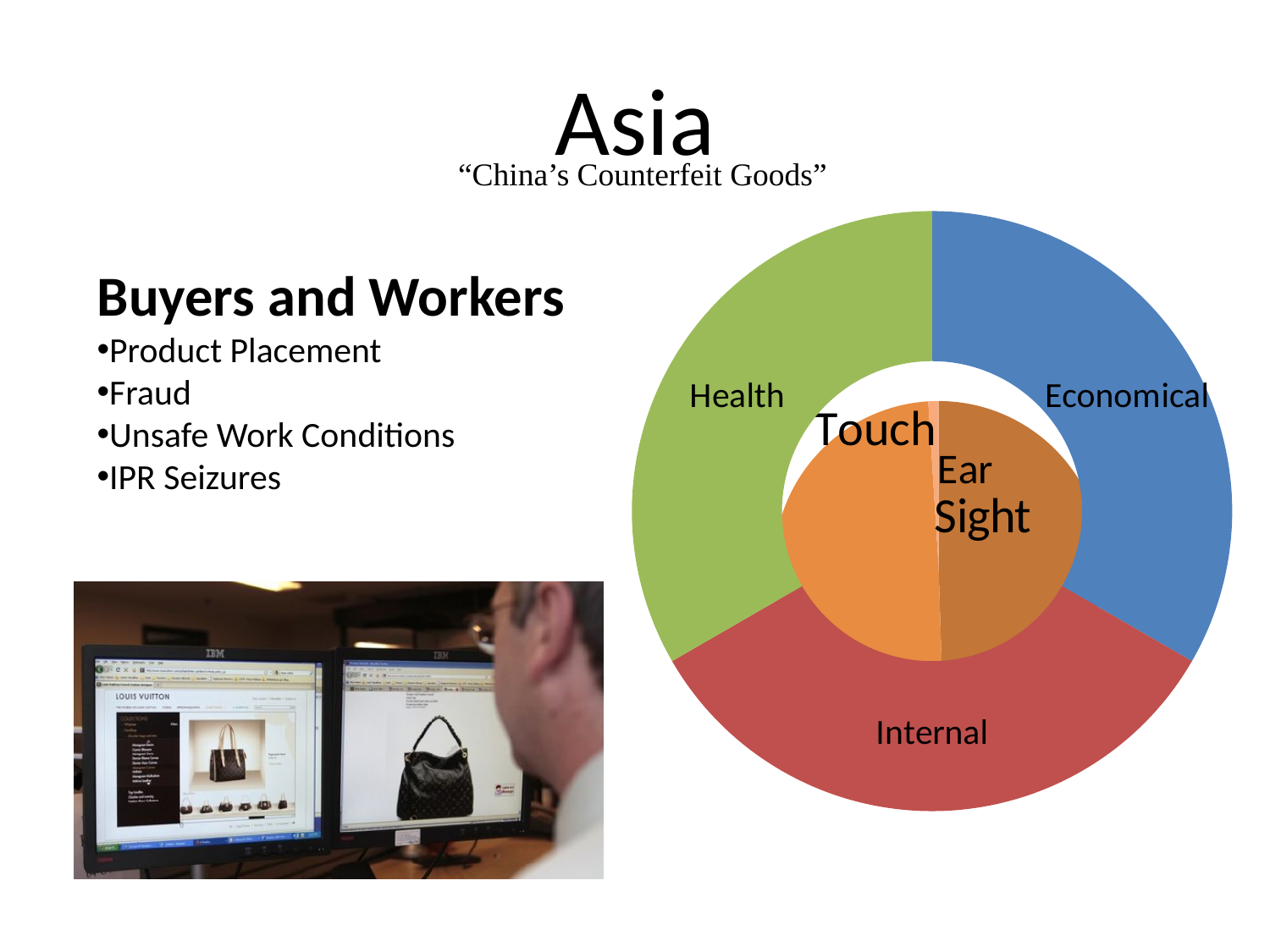
How many segments are labelled in the inner ring of the doughnut chart? 3 What are the labels of the three segments in the outer ring of the doughnut chart? Economical, Internal, Health What colour is the Internal segment in the outer ring of the doughnut chart? red How many segments are labelled in the outer ring of the doughnut chart? 3 In the inner ring of the doughnut chart, which is larger: Sight or Ear? Sight In the inner ring of the doughnut chart, which is larger: Touch or Ear? Touch What kind of chart is shown on the right side of the slide? doughnut chart Which segment of the inner ring of the doughnut chart is the smallest? Ear